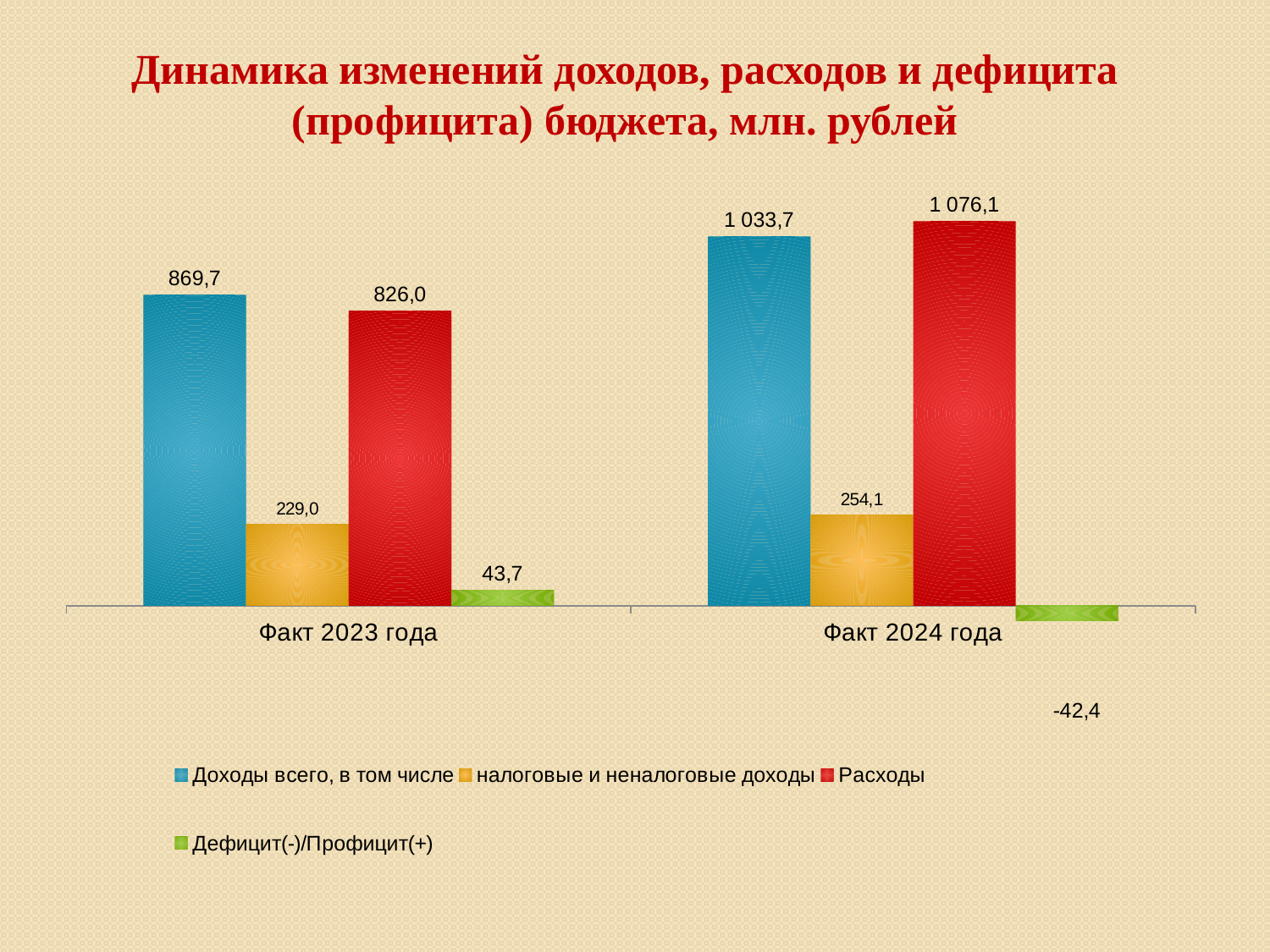
How many series does the legend list? 4 What kind of chart is shown on the slide? Bar chart Which series and category has the lowest value on the chart? Дефицит(-)/Профицит(+), Факт 2024 года (-42,4) What is the difference between Доходы всего, в том числе for Факт 2024 года and Факт 2023 года? 164,0 What is the value of Доходы всего, в том числе for Факт 2023 года? 869,7 What is the value of налоговые и неналоговые доходы for Факт 2024 года? 254,1 By how much did Расходы increase from Факт 2023 года to Факт 2024 года? 250,1 What is the value of Расходы for Факт 2024 года? 1 076,1 What is the value of Дефицит(-)/Профицит(+) for Факт 2024 года? -42,4 For Факт 2023 года, which is larger: Доходы всего, в том числе or Расходы? Доходы всего, в том числе How many categories are shown on the x axis? 2 Which series and category has the highest value on the chart? Расходы, Факт 2024 года (1 076,1)